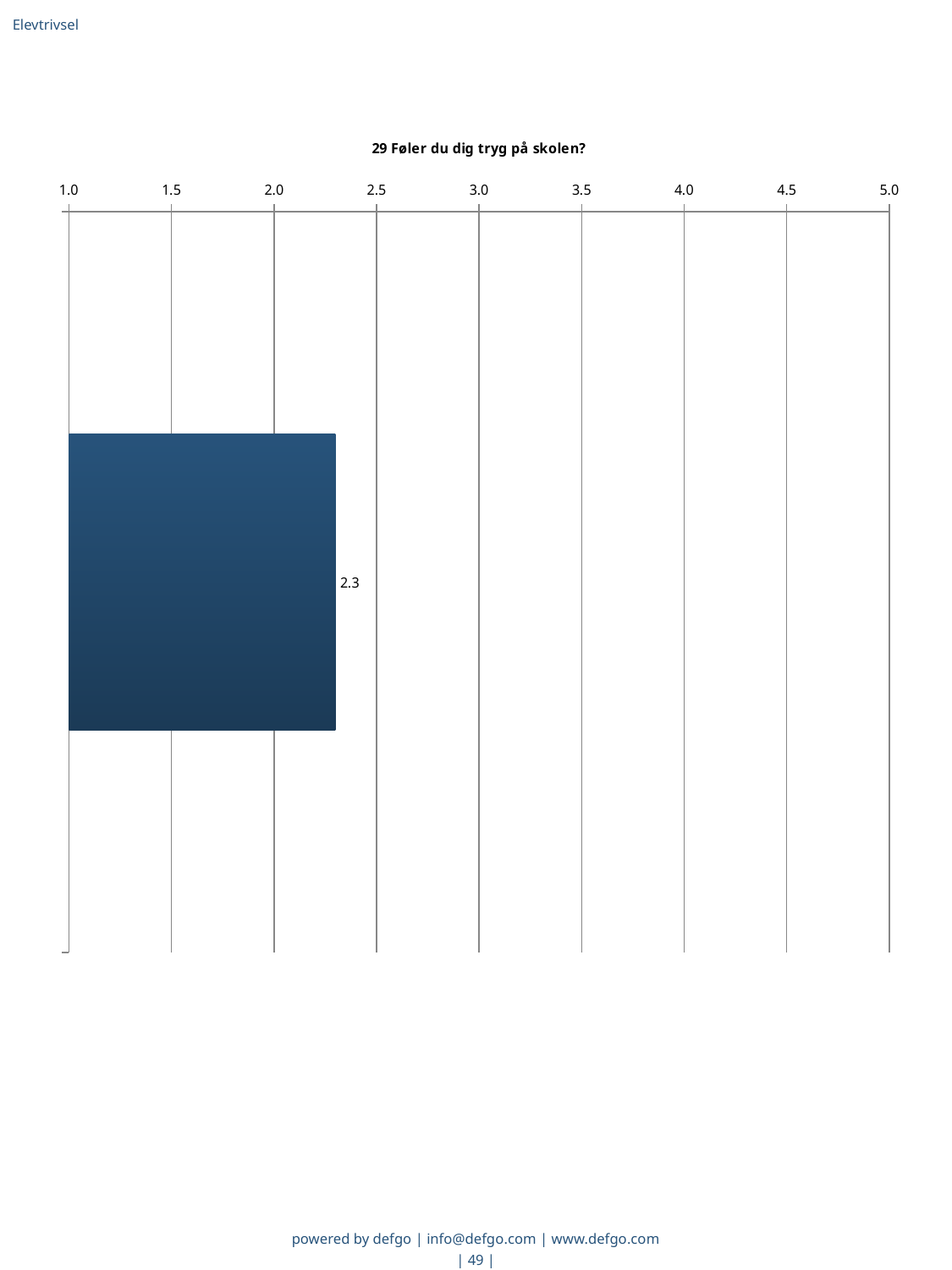
What is the highest value shown on the chart's axis? 5.0 What kind of chart is shown on the slide? bar chart What is the title of the chart? 29 Føler du dig tryg på skolen? Is the value of the bar greater or less than 3.0? less Is the value of the bar greater or less than 2.5? less How many bars are plotted in the chart? 1 What value is shown by the bar in the chart? 2.3 Is the value of the bar greater or less than 2.0? greater